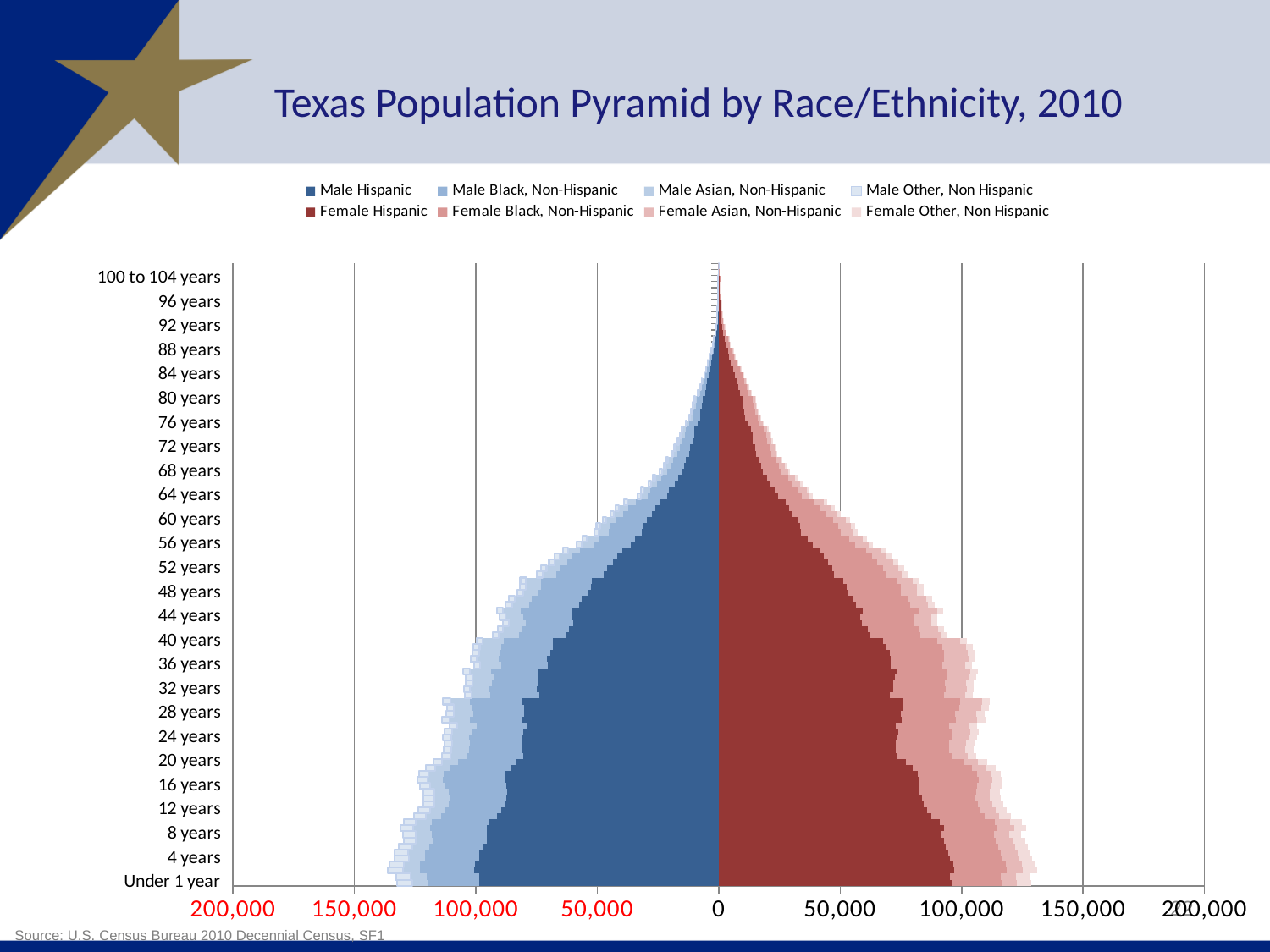
Which legend entry is shown in the darkest blue colour? Male Hispanic What kind of chart is shown on the slide? Bar chart (population pyramid) Is the total male population bar for Under 1 year greater or less than 100,000? greater Is the total male population bar for 100 to 104 years greater or less than 50,000? less How many series does the legend list? 8 Moving from the youngest ages at the bottom to the oldest ages at the top, do the bar lengths generally increase or decrease? decrease What is the title of the chart? Texas Population Pyramid by Race/Ethnicity, 2010 Which is larger, the Male Hispanic bar for Under 1 year or the Male Hispanic bar for 80 years? Under 1 year Which is larger, the total female bar for 28 years or the total female bar for 68 years? 28 years Is the total female population bar for 28 years greater or less than 100,000? greater